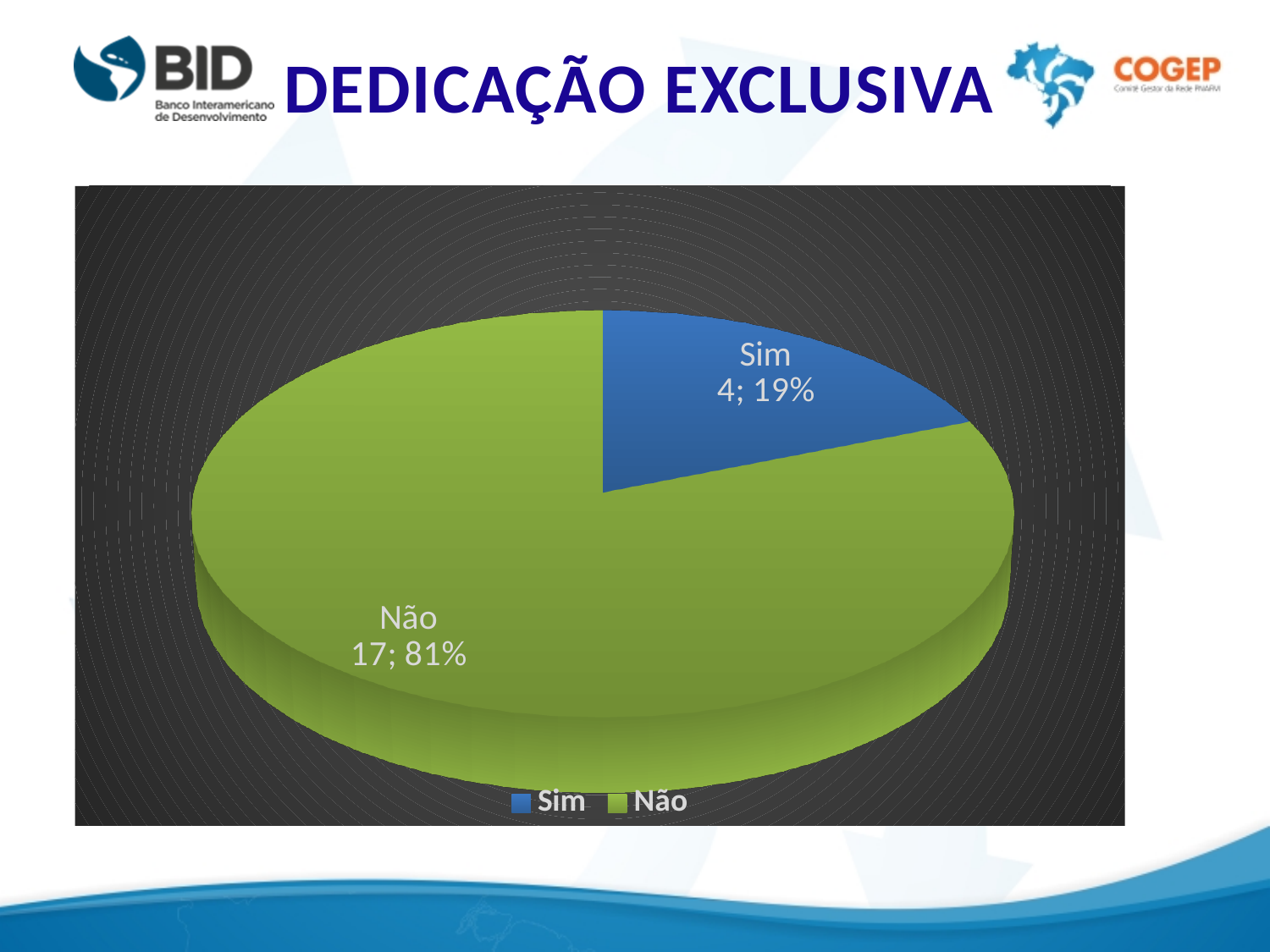
Which slice is the smallest? Sim What share of the pie does Não represent? 81% What share of the pie does Sim represent? 19% What colour is the Sim slice? blue What is the total of the values for Sim and Não? 21 Which is larger, Sim or Não? Não What kind of chart is shown on the slide? pie chart What is the value for Não? 17 How many slices does the pie chart have? 2 What is the value for Sim? 4 What is the difference between the values for Não and Sim? 13 Which slice is the largest? Não